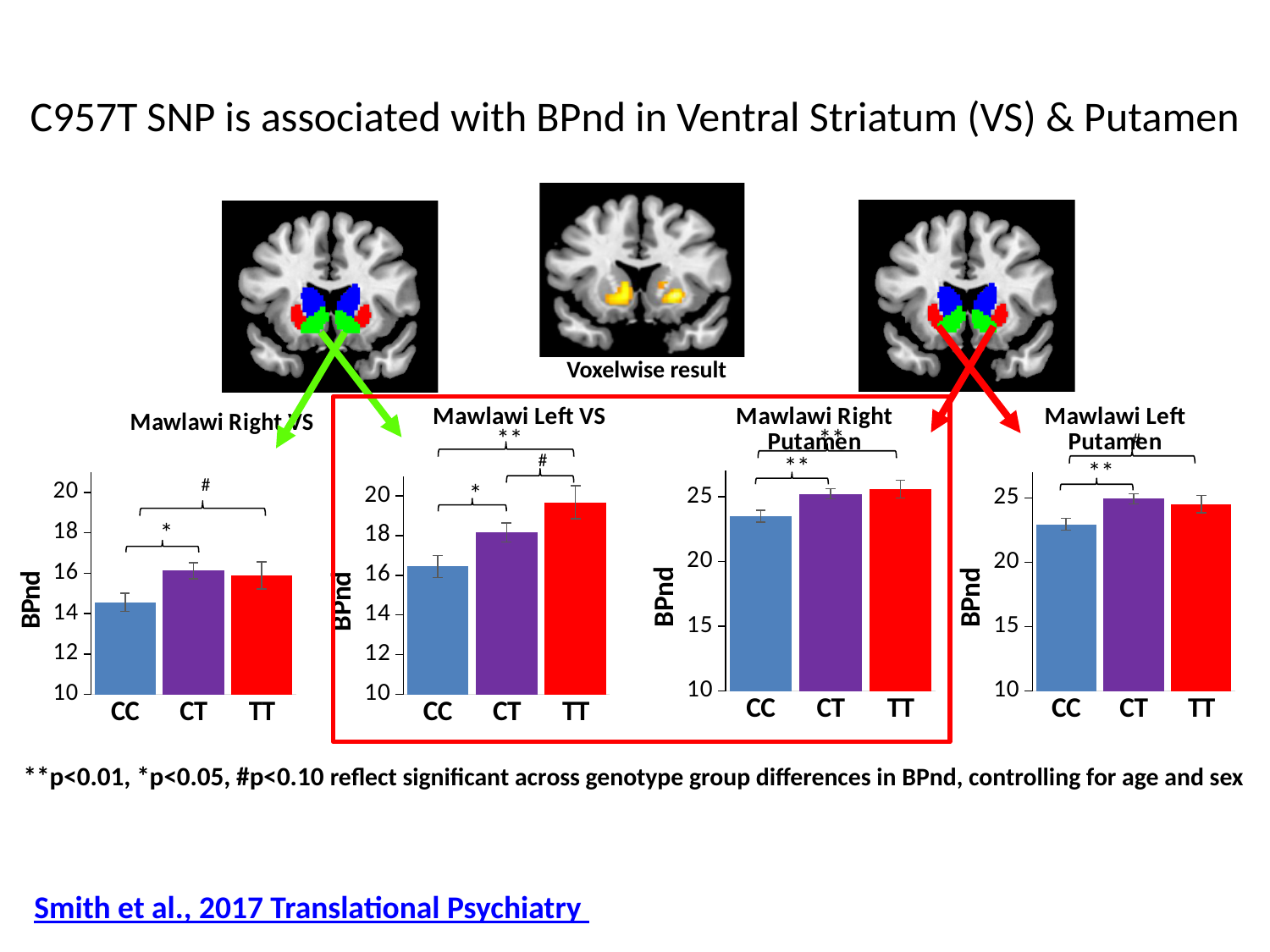
In the Mawlawi Left VS chart, which genotype group has the lowest BPnd? CC In the Mawlawi Right Putamen chart, which genotype group has the lowest BPnd? CC In the Mawlawi Right Putamen chart, is the value for CC greater or less than 25? less In the Mawlawi Left VS chart, is the value for TT greater or less than 18? greater In the Mawlawi Left Putamen chart, which genotype group has the lowest BPnd? CC In the Mawlawi Right VS chart, is the value for CC greater or less than 16? less What kind of chart is the Mawlawi Left VS chart? bar chart In the Mawlawi Right VS chart, which is larger, the value for CC or the value for CT? CT How many genotype groups are shown on the x axis of the Mawlawi Right Putamen chart? 3 In the Mawlawi Left VS chart, which genotype group has the highest BPnd? TT What is the label on the y axis of the Mawlawi Left Putamen chart? BPnd